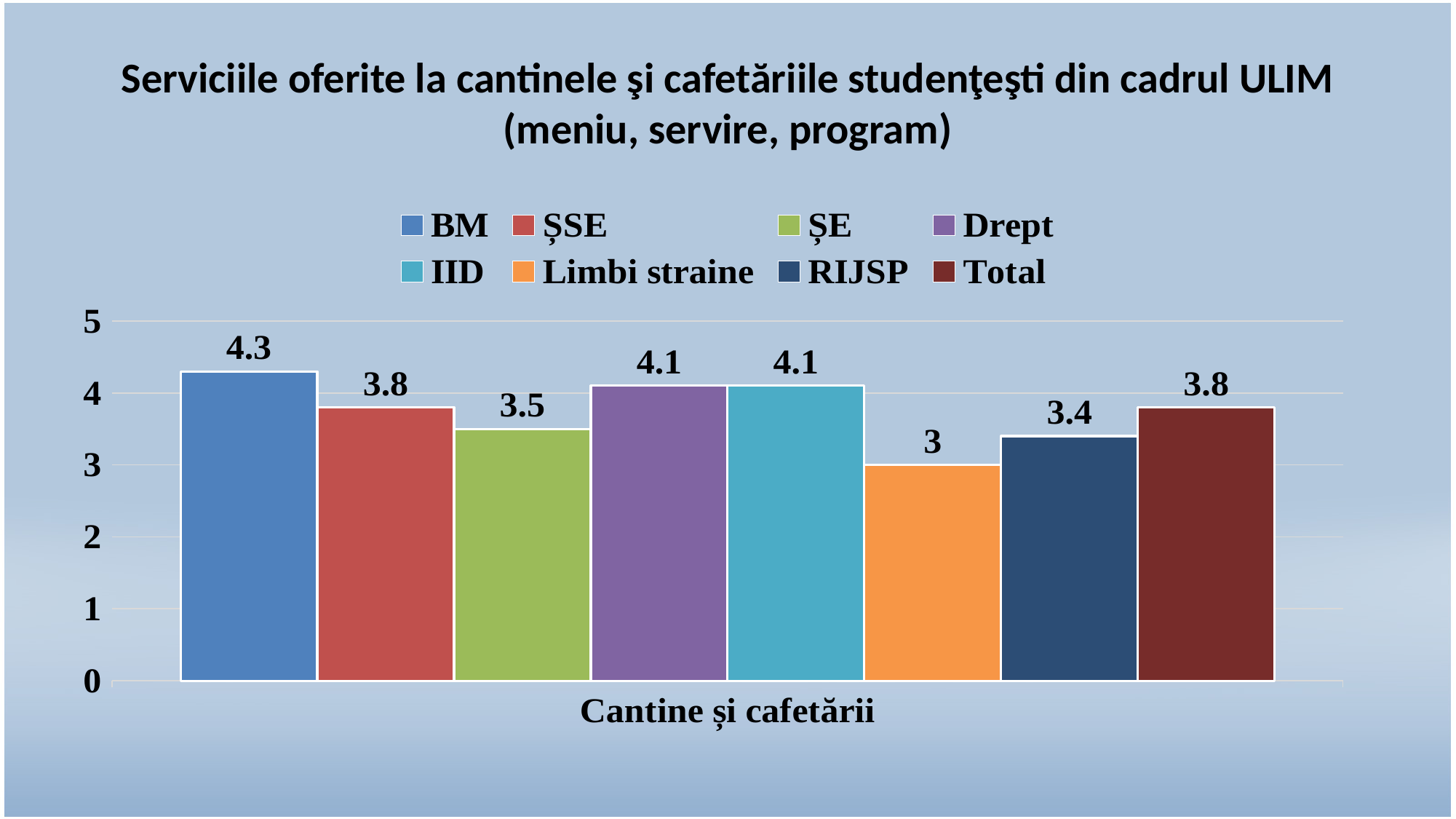
How many series does the legend list? 8 What is the difference between the values for BM and ȘE? 0.8 Which series has the highest value? BM What is the value for Total? 3.8 What is the label on the horizontal axis? Cantine și cafetării What kind of chart is shown on the slide? bar chart Is the value for ȘSE greater or less than 4? less Which is larger, the value for Drept or the value for RIJSP? Drept What is the value for BM? 4.3 What is the value for Limbi straine? 3 What is the value for RIJSP? 3.4 Which series has the lowest value? Limbi straine